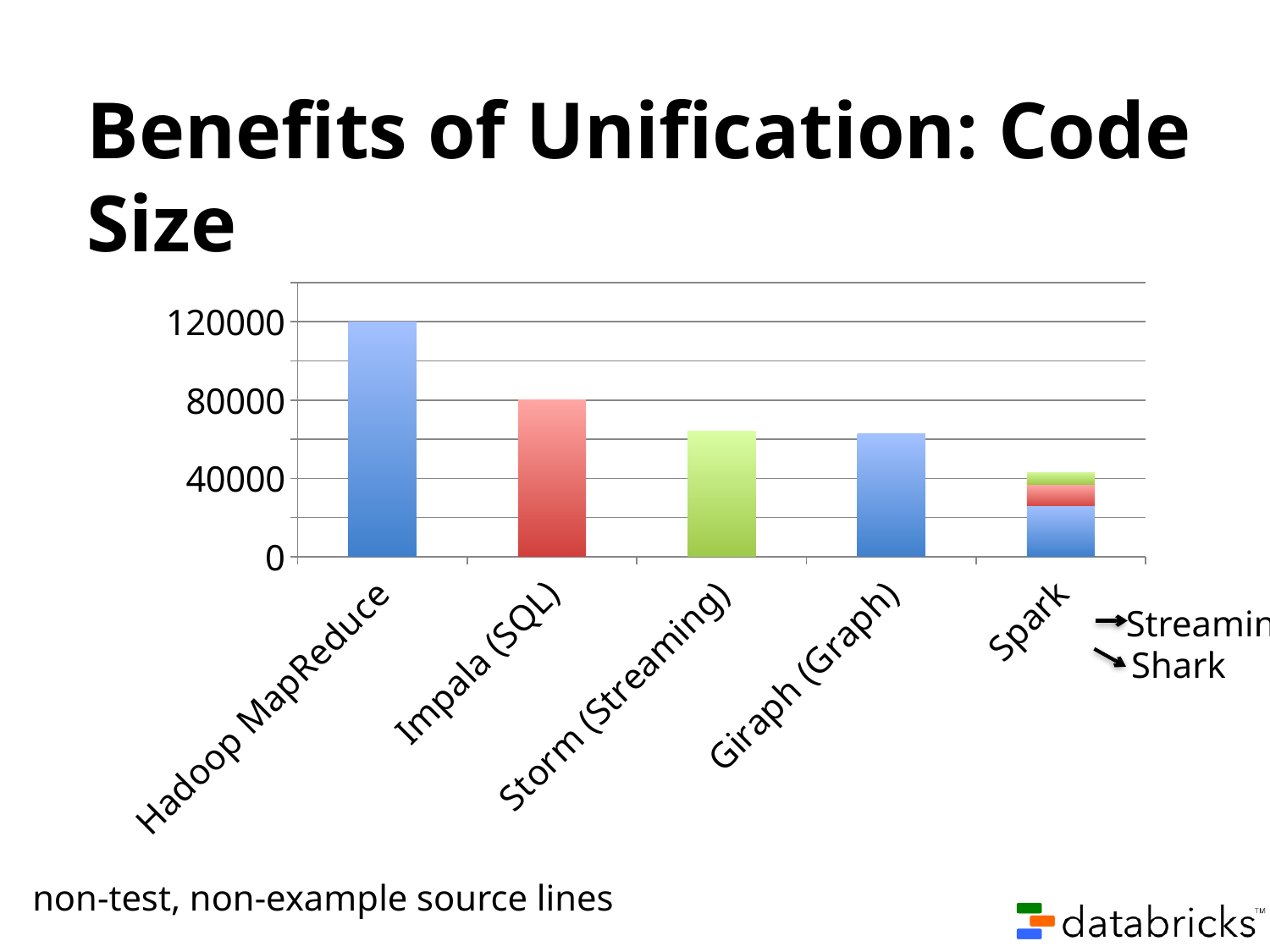
What is the value for Impala (SQL)? 80000 What kind of chart is shown on the slide? bar chart Is the value for Storm (Streaming) greater or less than 40000? greater Which category has the lowest value? Spark How many categories are plotted on the x axis? 5 Which category has the highest value? Hadoop MapReduce Which is larger, the value for Hadoop MapReduce or the value for Impala (SQL)? Hadoop MapReduce What is the difference between the values for Hadoop MapReduce and Impala (SQL)? 40000 Do the values generally rise or fall from left to right along the x axis? fall What is the value for Hadoop MapReduce? 120000 Is the total value for Spark greater or less than 80000? less Is the value for Giraph (Graph) greater or less than 80000? less